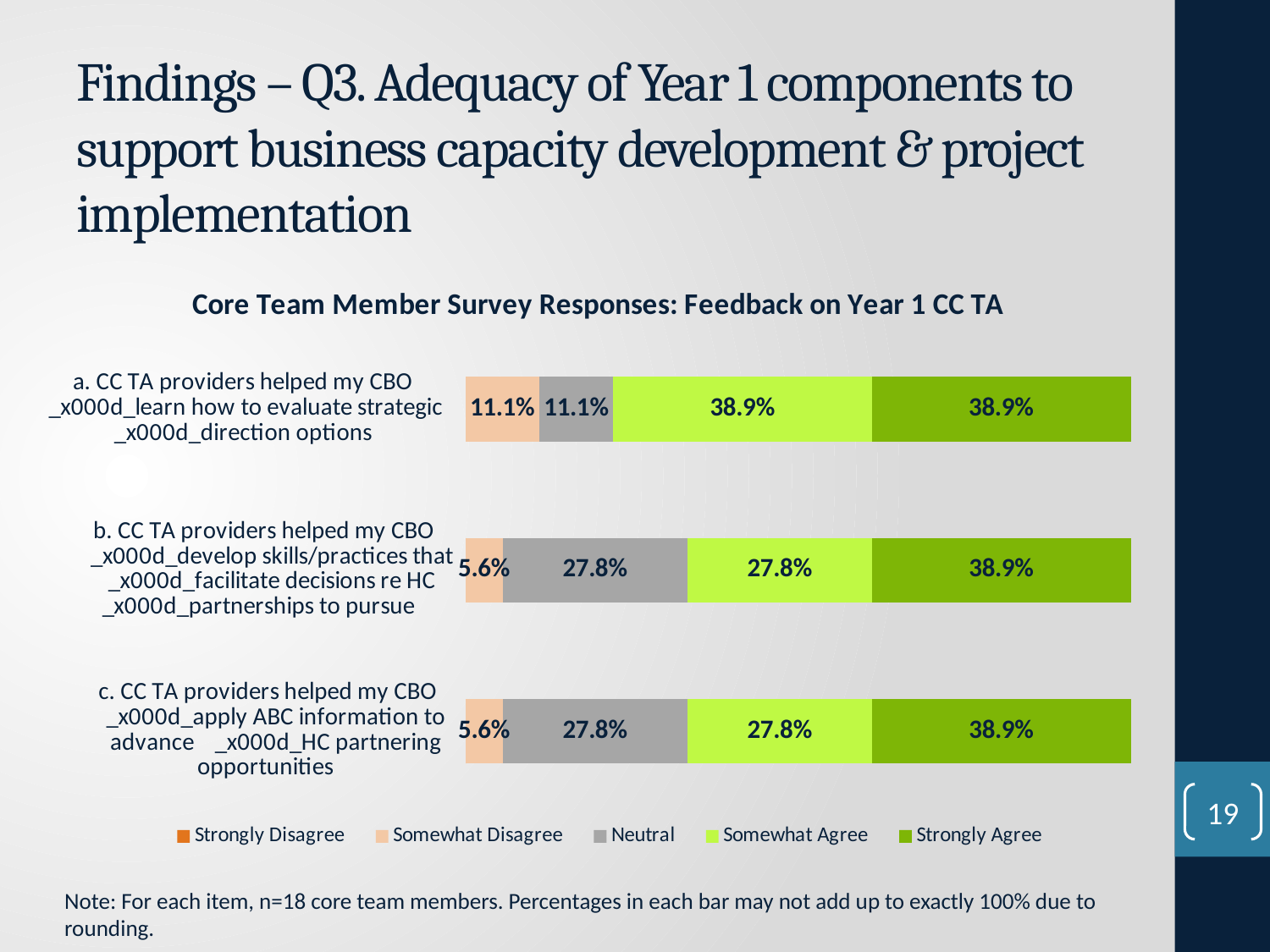
What is the Somewhat Disagree percentage for item c (CC TA providers helped my CBO apply ABC information to advance HC partnering opportunities)? 5.6% For item b, how much larger is the Strongly Agree percentage than the Neutral percentage? 11.1 percentage points What is the title of the chart? Core Team Member Survey Responses: Feedback on Year 1 CC TA How many survey items (bars) are plotted in the chart? 3 For item a, what is the difference between the Somewhat Agree percentage and the Somewhat Disagree percentage? 27.8 percentage points Which response category has the largest share for item b? Strongly Agree What kind of chart is shown on the slide? Stacked bar chart What percentage of respondents chose Strongly Agree for item a (CC TA providers helped my CBO learn how to evaluate strategic direction options)? 38.9% What is the Neutral percentage for item b (CC TA providers helped my CBO develop skills/practices that facilitate decisions re HC partnerships to pursue)? 27.8% How many series does the chart legend list? 5 Which legend entry is shown in dark green? Strongly Agree Which item has the larger Neutral percentage, item a or item b? Item b